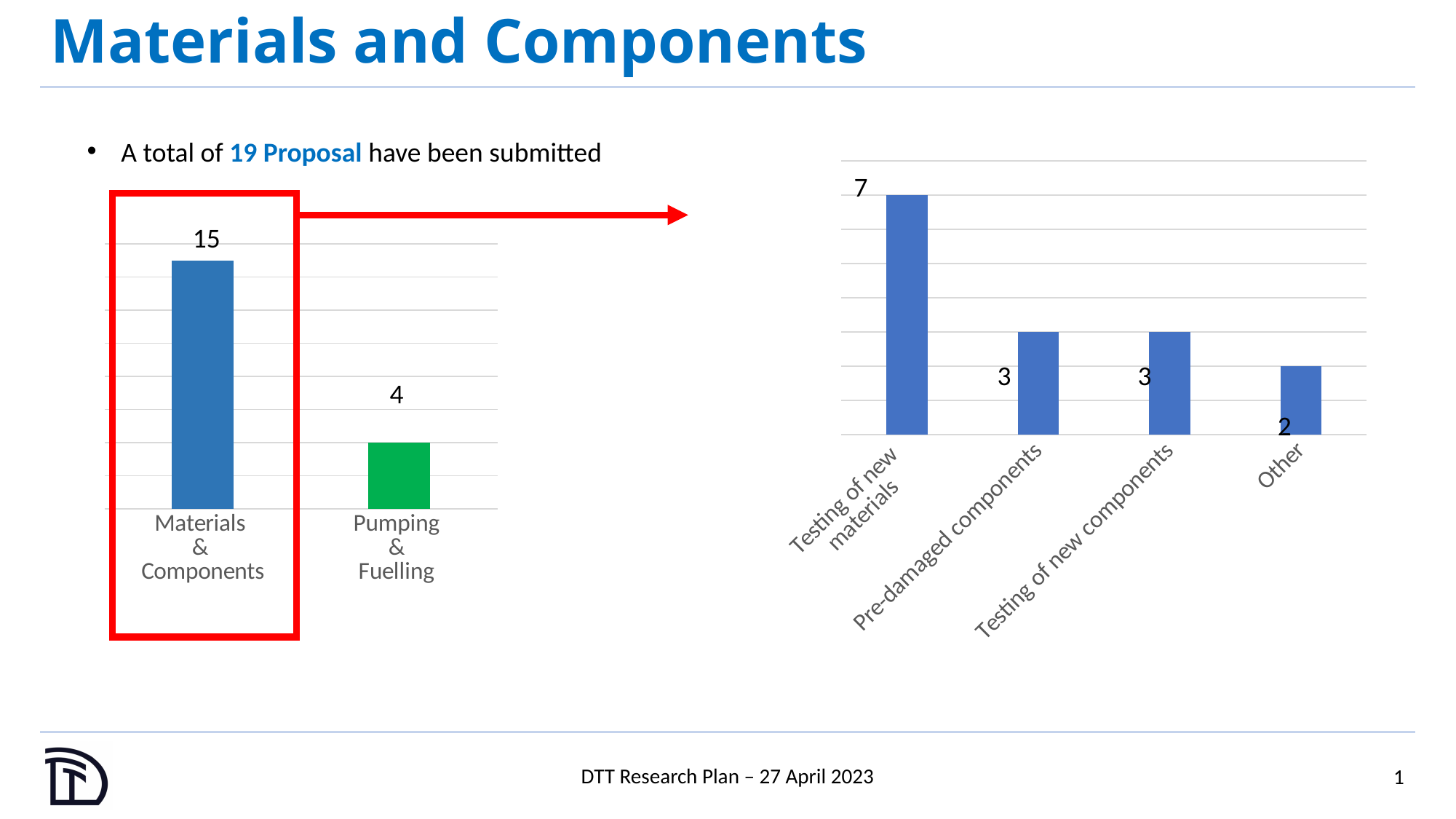
In the left chart, how many categories are shown? 2 In the right chart, what is the value for Pre-damaged components? 3 In the right chart, how many categories are shown? 4 In the right chart, what is the value for Other? 2 In the right chart, which category has the highest value? Testing of new materials In the left chart, what is the difference between Materials & Components and Pumping & Fuelling? 11 In the right chart, what is the value for Testing of new materials? 7 In the left chart, what is the value for Pumping & Fuelling? 4 In the left chart, what is the value for Materials & Components? 15 In the left chart, which category has the higher value? Materials & Components In the right chart, which category has the lowest value? Other What kind of chart is the right chart? Bar chart